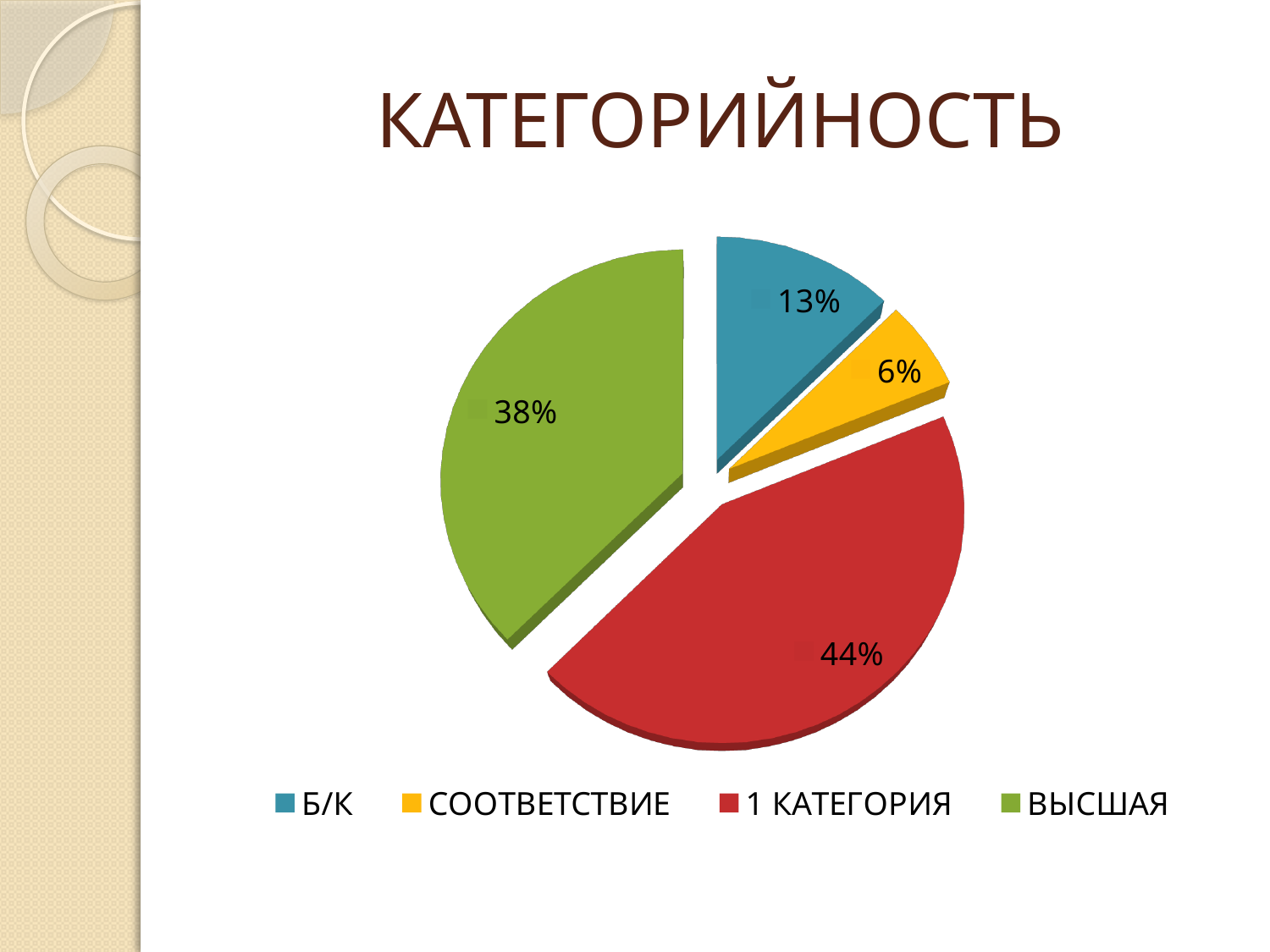
What is the difference in percentage points between Б/К and СООТВЕТСТВИЕ? 7 Which category has the smallest share of the pie? СООТВЕТСТВИЕ What percentage does the ВЫСШАЯ slice show? 38% Which is larger, the share for ВЫСШАЯ or the share for Б/К? ВЫСШАЯ What percentage does the СООТВЕТСТВИЕ slice show? 6% What is the difference in percentage points between 1 КАТЕГОРИЯ and ВЫСШАЯ? 6 What percentage does the Б/К slice show? 13% What is the title of the chart? КАТЕГОРИЙНОСТЬ What percentage does the 1 КАТЕГОРИЯ slice show? 44% Which category has the largest share of the pie? 1 КАТЕГОРИЯ What kind of chart is shown on the slide? Pie chart How many slices does the pie chart have? 4